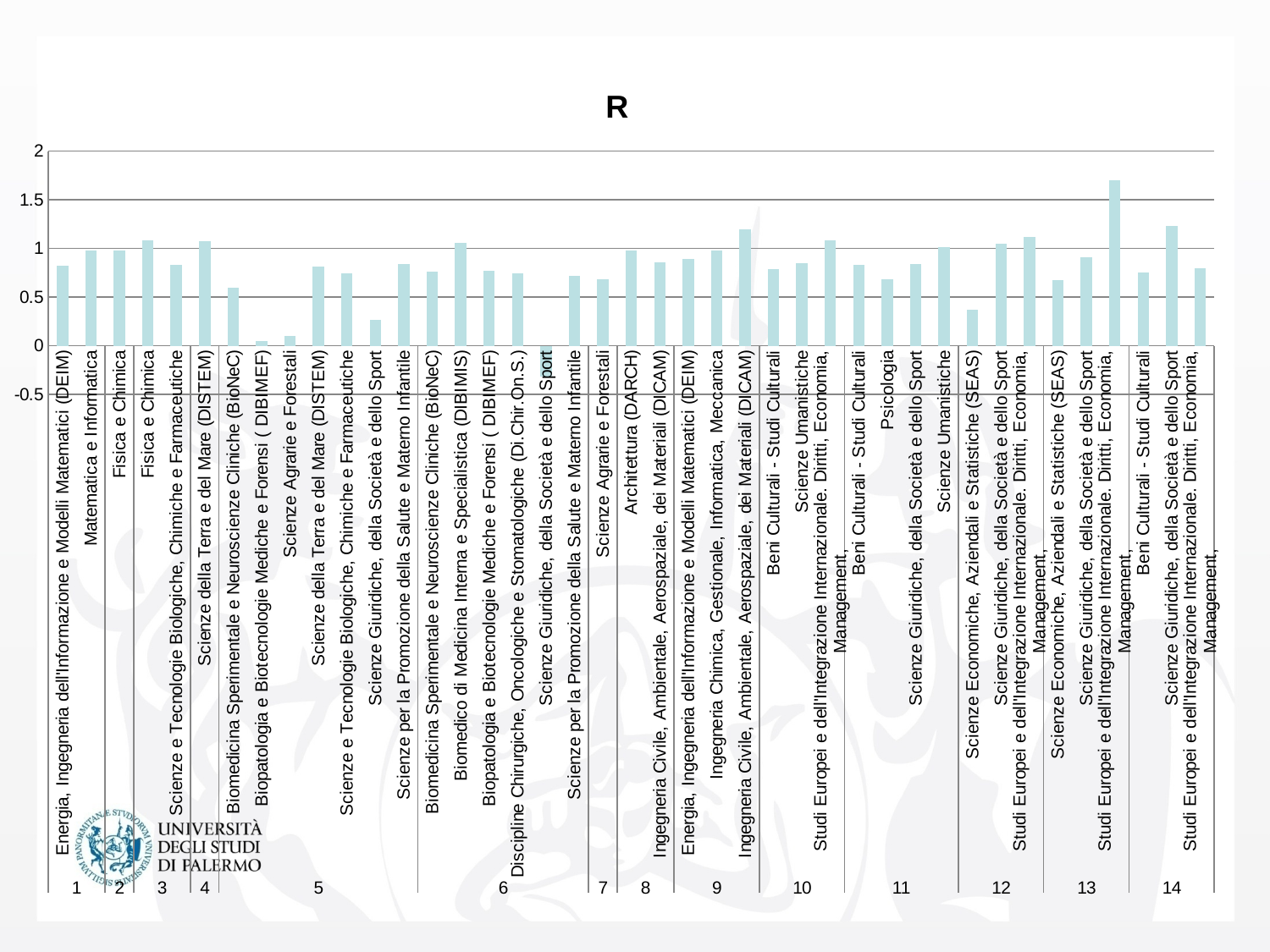
Which category has the tallest bar in the chart? Studi Europei e dell'Integrazione Internazionale. Diritti, Economia, Management (group 13) Is the value for Scienze Economiche, Aziendali e Statistiche (SEAS) in group 12 greater or less than 0.5? less What is the title of the chart? R What is the highest value shown on the vertical axis? 2 Is the value for Psicologia greater or less than 1? less Is the value for Architettura (DARCH) greater or less than 0.5? greater Which is larger, the value for Matematica e Informatica or the value for Psicologia? Matematica e Informatica How many numbered groups are shown along the bottom of the chart? 14 Which is larger, the value for Architettura (DARCH) or the value for Psicologia? Architettura (DARCH) What kind of chart is shown on the slide? bar chart